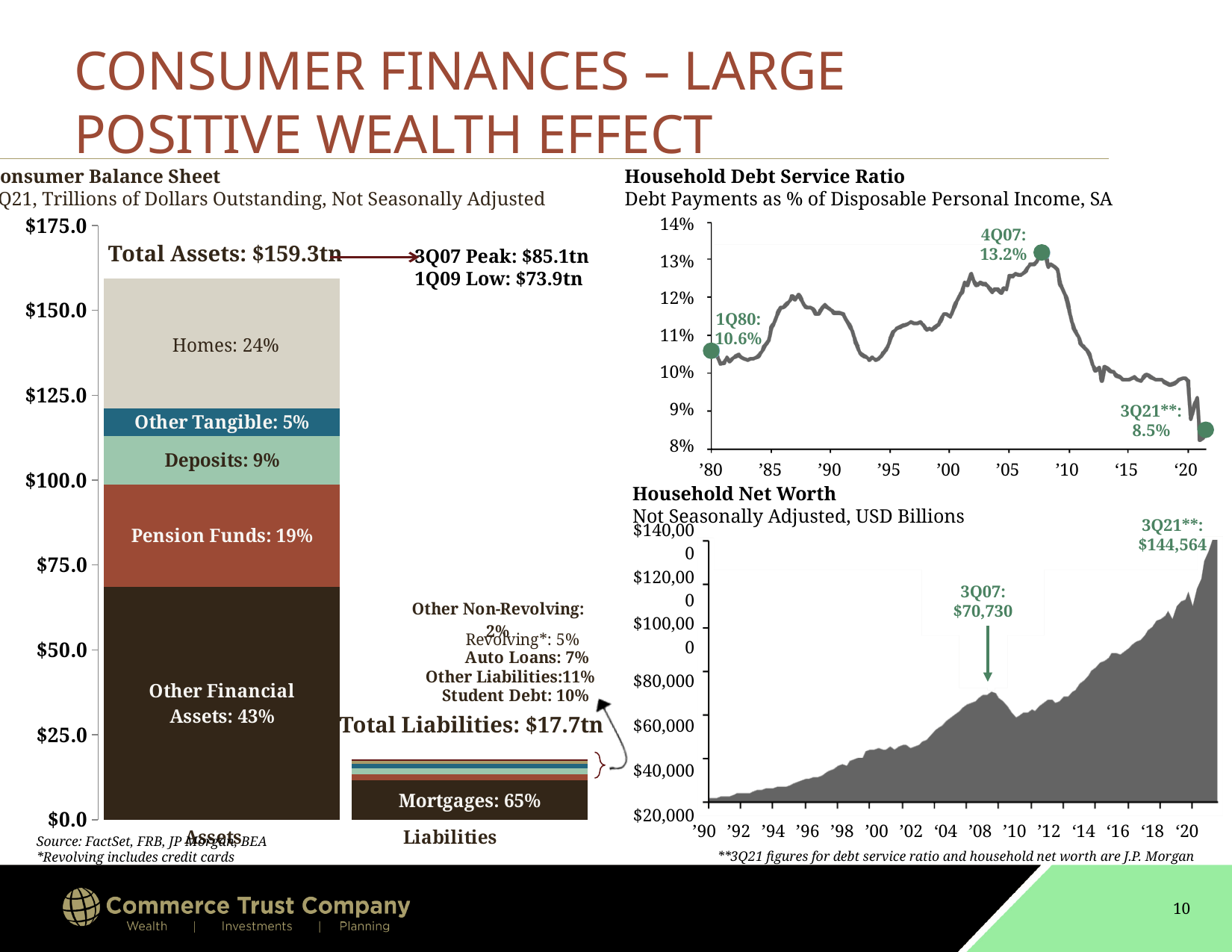
On the Consumer Balance Sheet chart, what is the difference between Total Assets and Total Liabilities? $141.6tn On the Consumer Balance Sheet chart, what percentage of assets is Homes? 24% On the Consumer Balance Sheet chart, which component makes up the largest share of liabilities? Mortgages On the Consumer Balance Sheet chart, which is a larger share of assets, Pension Funds or Deposits? Pension Funds On the Consumer Balance Sheet chart, what is the value of Total Assets? $159.3tn On the Consumer Balance Sheet chart, what is the value of Total Liabilities? $17.7tn On the Consumer Balance Sheet chart, which component makes up the largest share of assets? Other Financial Assets On the Household Debt Service Ratio chart, what was the ratio at 3Q21? 8.5% On the Household Debt Service Ratio chart, what was the ratio at 4Q07? 13.2% On the Household Net Worth chart, what is the value labeled for 3Q21? $144,564 On the Household Debt Service Ratio chart, by how many percentage points did the ratio fall from 4Q07 to 3Q21? 4.7 percentage points What kind of chart is the Household Net Worth chart? Area chart